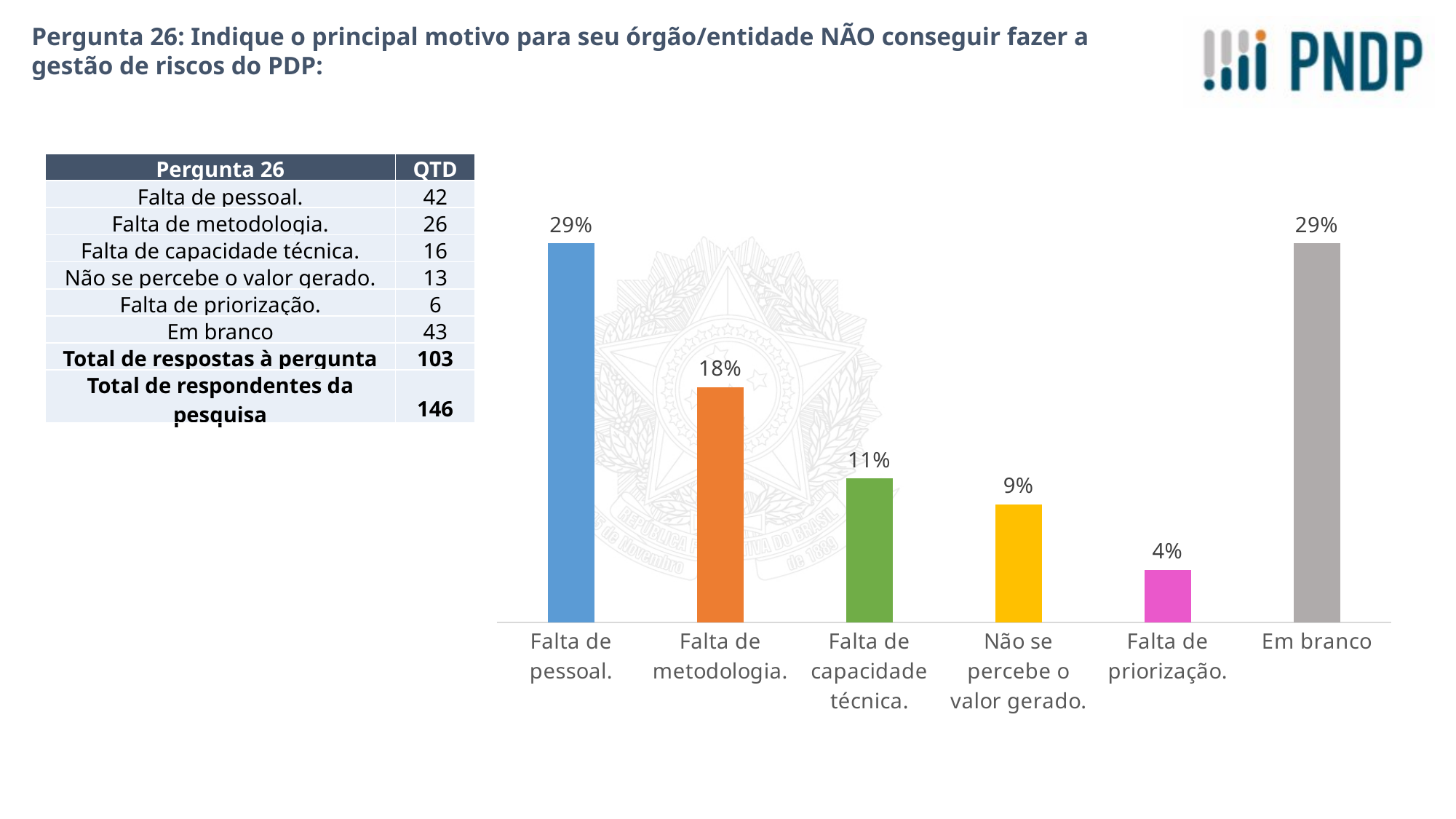
What percentage is shown for "Falta de capacidade técnica." in the chart? 11% What kind of chart is shown on the slide? Bar chart What colour is the bar for "Falta de metodologia."? Orange What percentage is shown for "Em branco" in the chart? 29% Which category has the lowest percentage in the chart? Falta de priorização. What percentage is shown for "Não se percebe o valor gerado." in the chart? 9% How many categories are plotted in the chart? 6 What is the difference in percentage points between "Falta de pessoal." and "Falta de priorização."? 25 What percentage is shown for "Falta de metodologia." in the chart? 18% What percentage is shown for "Falta de pessoal." in the chart? 29% What is the difference in percentage points between "Falta de metodologia." and "Falta de capacidade técnica."? 7 Which is larger in the chart: "Não se percebe o valor gerado." or "Falta de priorização."? Não se percebe o valor gerado.